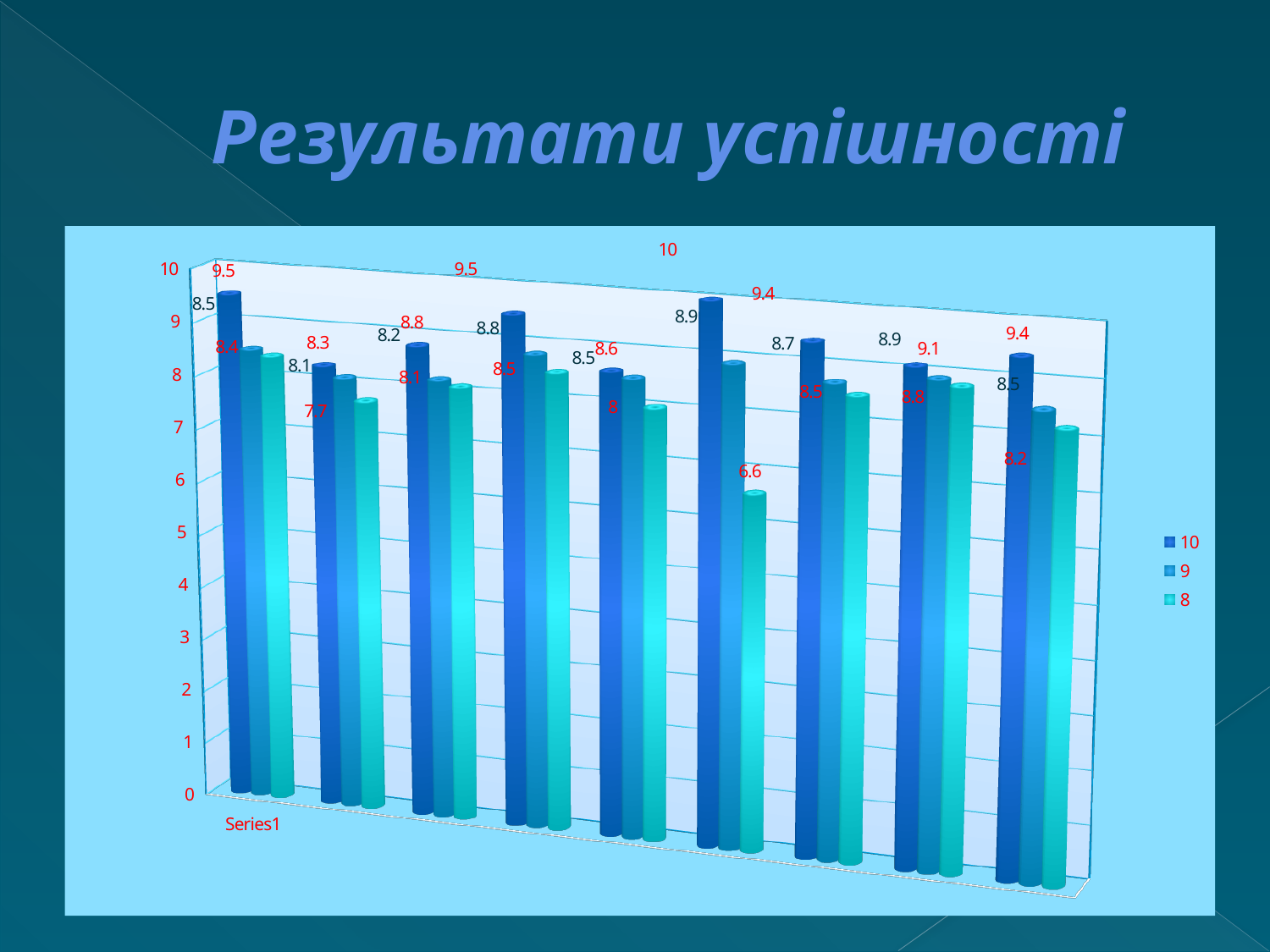
What kind of chart is shown on the slide? bar chart Is the value of the cyan (series 8) bar in the sixth group from the left greater or less than 7? less What is the lowest value labelled anywhere in the chart? 6.6 In the first group from the left, which is larger: the series 10 bar (9.5) or the series 8 bar (8.4)? series 10 (9.5) How many series does the legend list? 3 What is the highest value labelled anywhere in the chart? 10 What is the difference between the series 10 bar (10) and the series 8 bar (6.6) in the sixth group from the left? 3.4 How many groups of bars are plotted in the chart? 9 What is the title of the chart on the slide? Результати успішності What is the value of the cyan (series 8) bar in the sixth group from the left? 6.6 What are the series names listed in the legend? 10, 9, 8 What is the value of the dark blue (series 10) bar in the sixth group from the left? 10